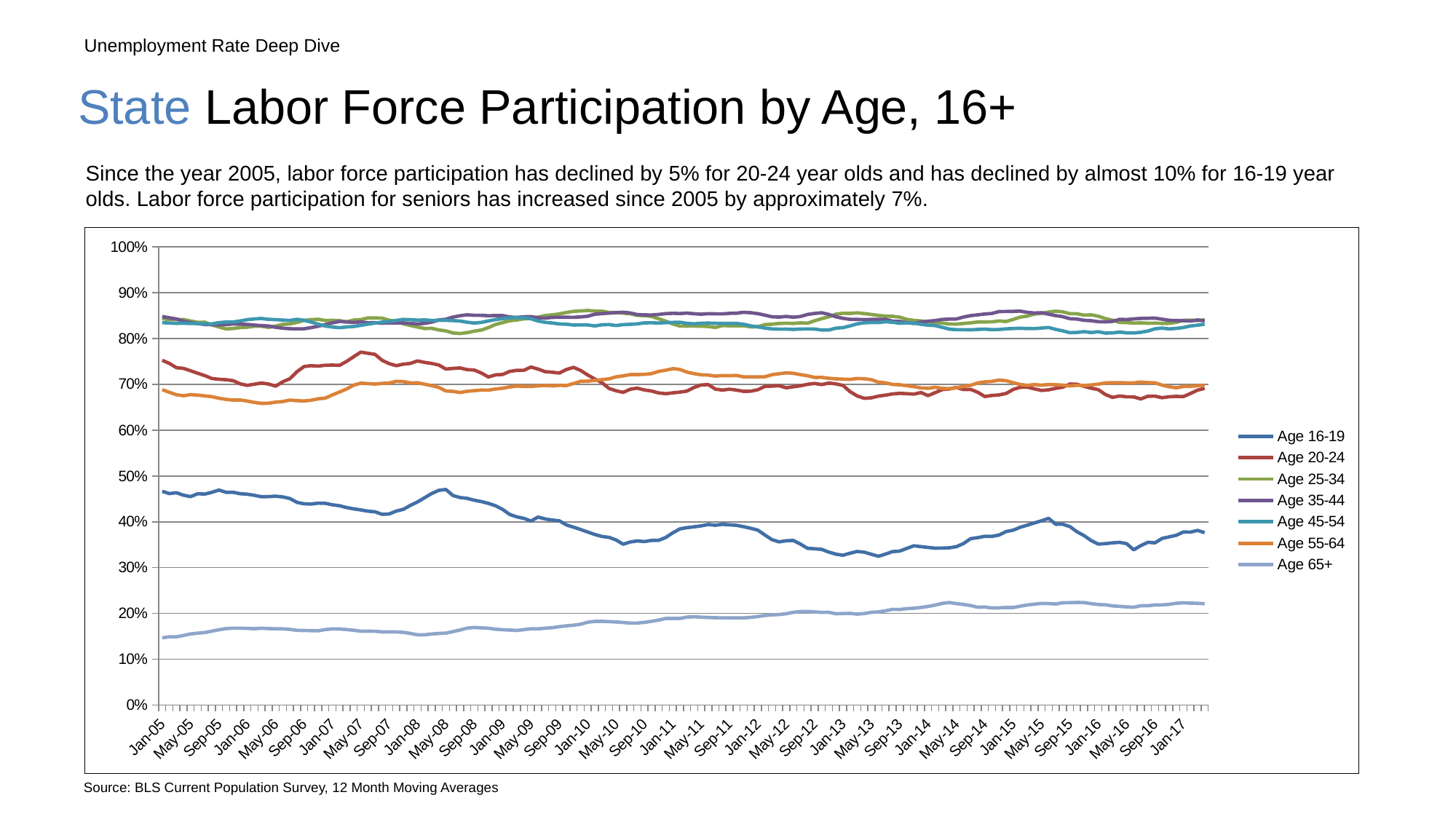
Is the value for Age 16-19 at Jan-13 greater or less than 40%? less Does the Age 16-19 line generally rise or fall from Jan-05 to Jan-17? fall Which series has the lowest values across the whole chart? Age 65+ Is the value for Age 65+ at Jan-05 greater or less than 20%? less At Jan-05, which is larger: Age 20-24 or Age 55-64? Age 20-24 How many series does the legend list? 7 Is the value for Age 20-24 at Jan-05 greater or less than 70%? greater What is the title of the slide containing the chart? State Labor Force Participation by Age, 16+ Does the Age 65+ line generally rise or fall from Jan-05 to Jan-17? rise What kind of chart is shown on the slide? line chart